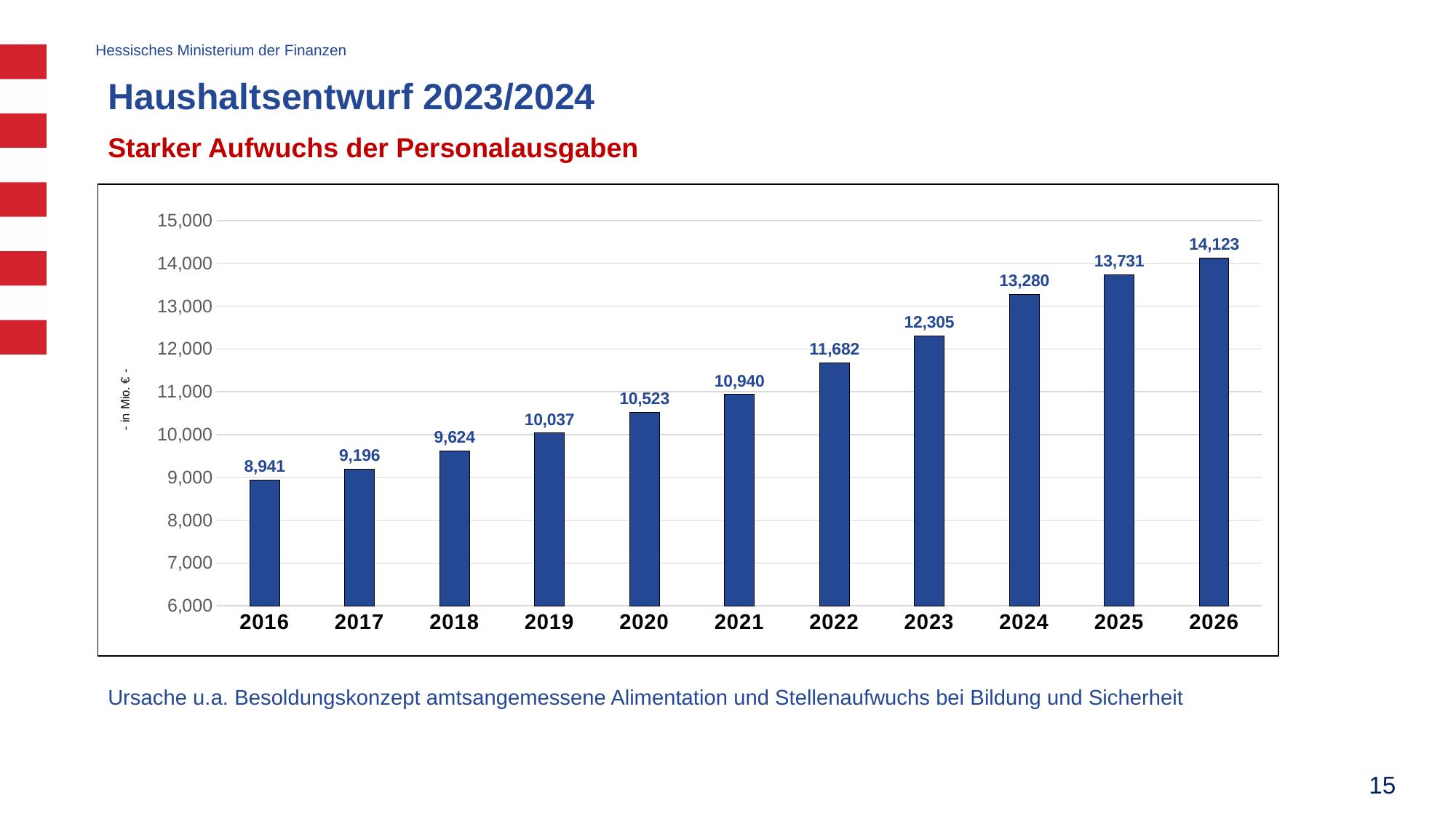
What unit is given on the y axis label? in Mio. € What is the value for 2023? 12,305 Which year has the highest value? 2026 What kind of chart is shown? bar chart Which is larger, the value for 2019 or the value for 2020? 2020 What is the value for 2026? 14,123 Is the value for 2021 greater or less than 11,000? less How many years are shown on the x axis? 11 Which year has the lowest value? 2016 Do the values rise or fall from 2016 to 2026? rise What is the value for 2016? 8,941 What is the difference between the values for 2024 and 2023? 975